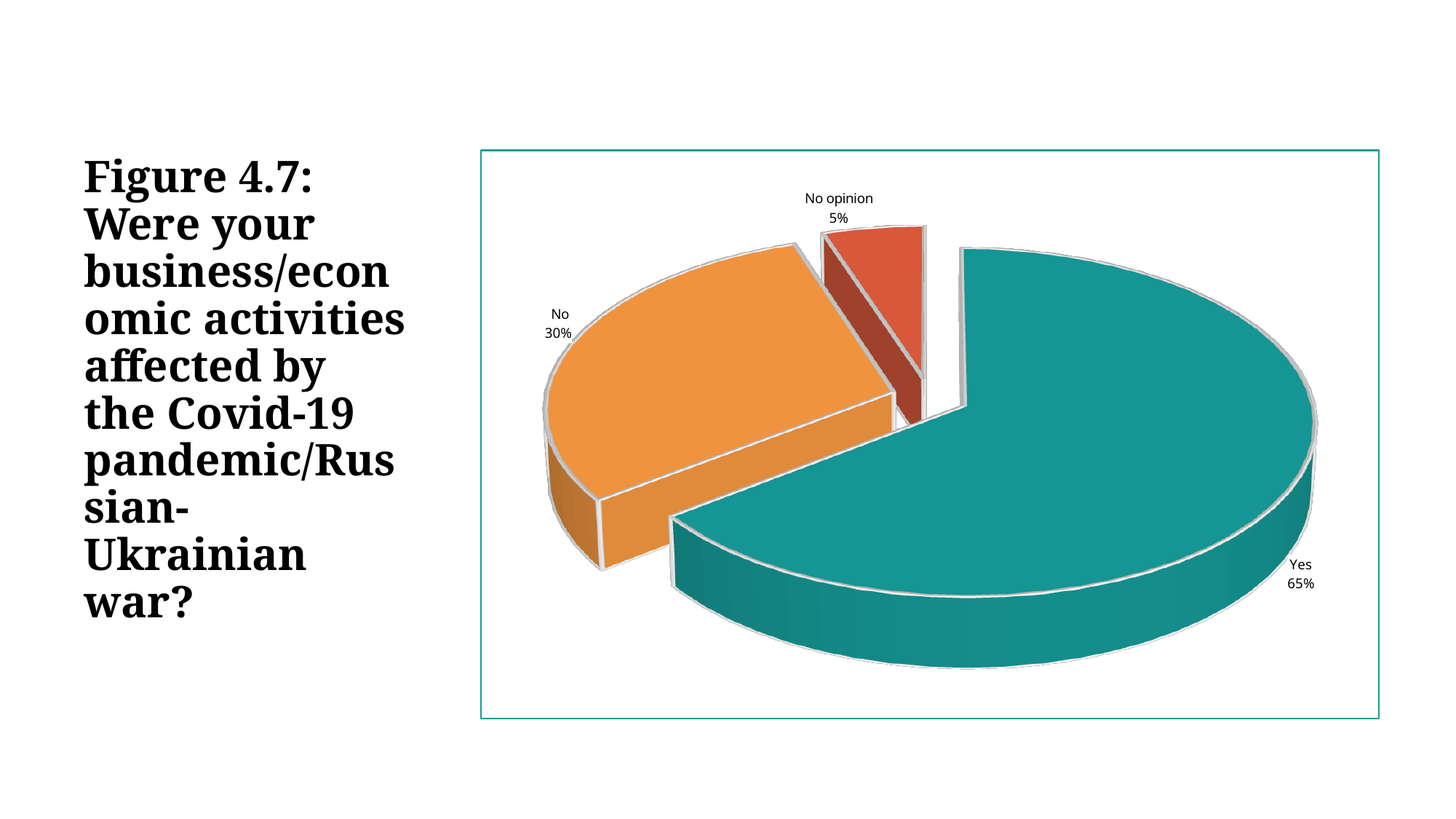
What colour is the Yes slice? Teal What percentage of respondents answered Yes? 65% What is the difference in percentage points between the Yes and No shares? 35 How many slices does the pie chart have? 3 What percentage of respondents answered No? 30% Which response has the largest share of the pie? Yes What kind of chart is shown on the slide? Pie chart Which is larger, the share for No or the share for No opinion? No What is the difference in percentage points between the No and No opinion shares? 25 Which response has the smallest share of the pie? No opinion What percentage of respondents had No opinion? 5% What is the figure number given in the slide title? Figure 4.7